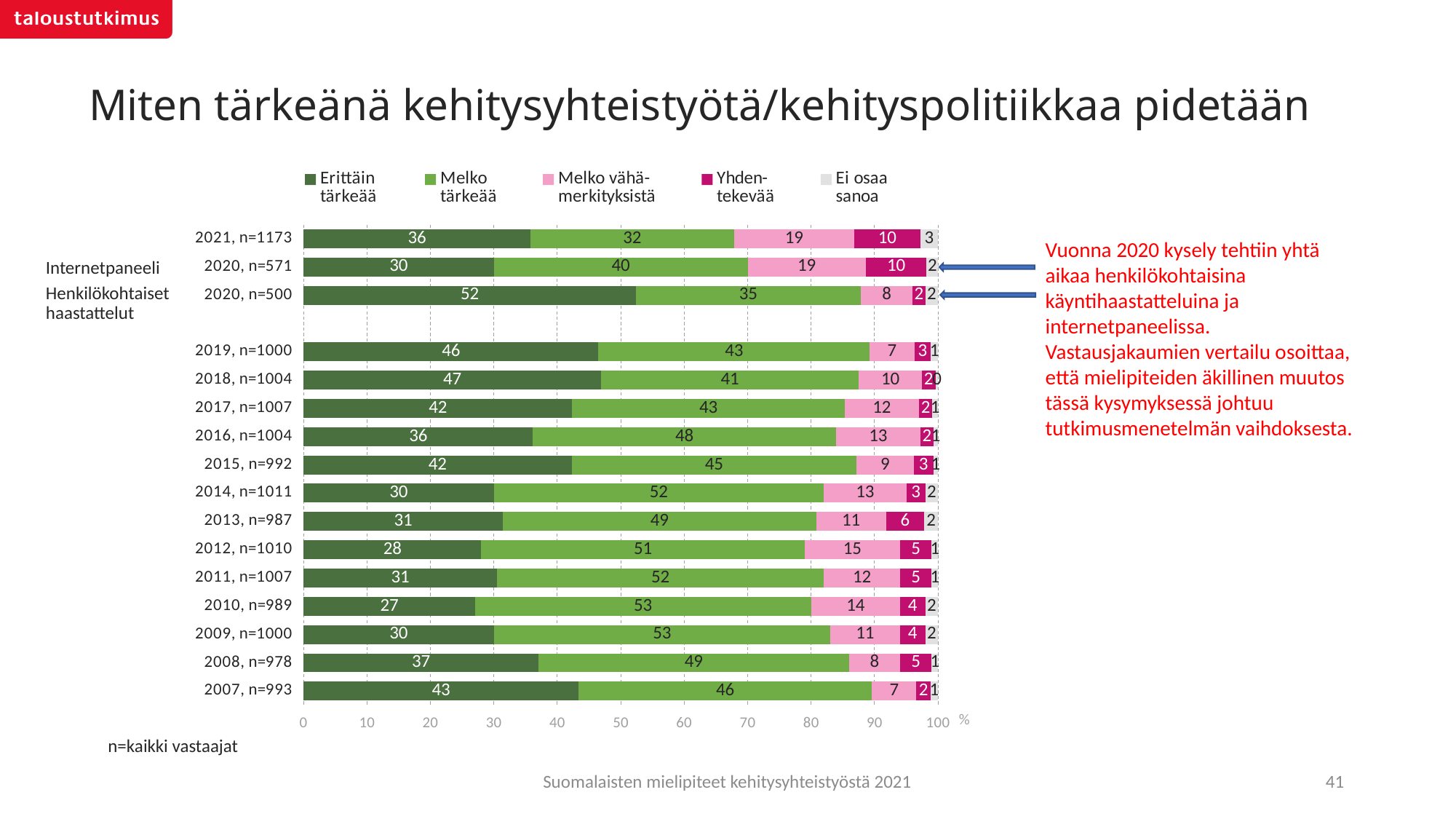
How many bars (survey rows) are plotted in the chart? 16 How many series does the legend list? 5 What is the total of the stacked bar for 2021, n=1173? 100 Which row has the lowest 'Erittäin tärkeää' value? 2010, n=989 Which has the larger 'Erittäin tärkeää' value: 2007, n=993 or 2008, n=978? 2007, n=993 Which row has the highest 'Erittäin tärkeää' value? 2020, n=500 What is the 'Melko vähämerkityksistä' value for 2012, n=1010? 15 What is the 'Yhdentekevää' value for 2013, n=987? 6 What kind of chart is shown on the slide? Stacked bar chart What is the difference between the 'Erittäin tärkeää' values for 2021, n=1173 and 2020, n=571? 6 What is the 'Melko tärkeää' value for 2020, n=571? 40 What is the 'Erittäin tärkeää' value for 2021, n=1173? 36